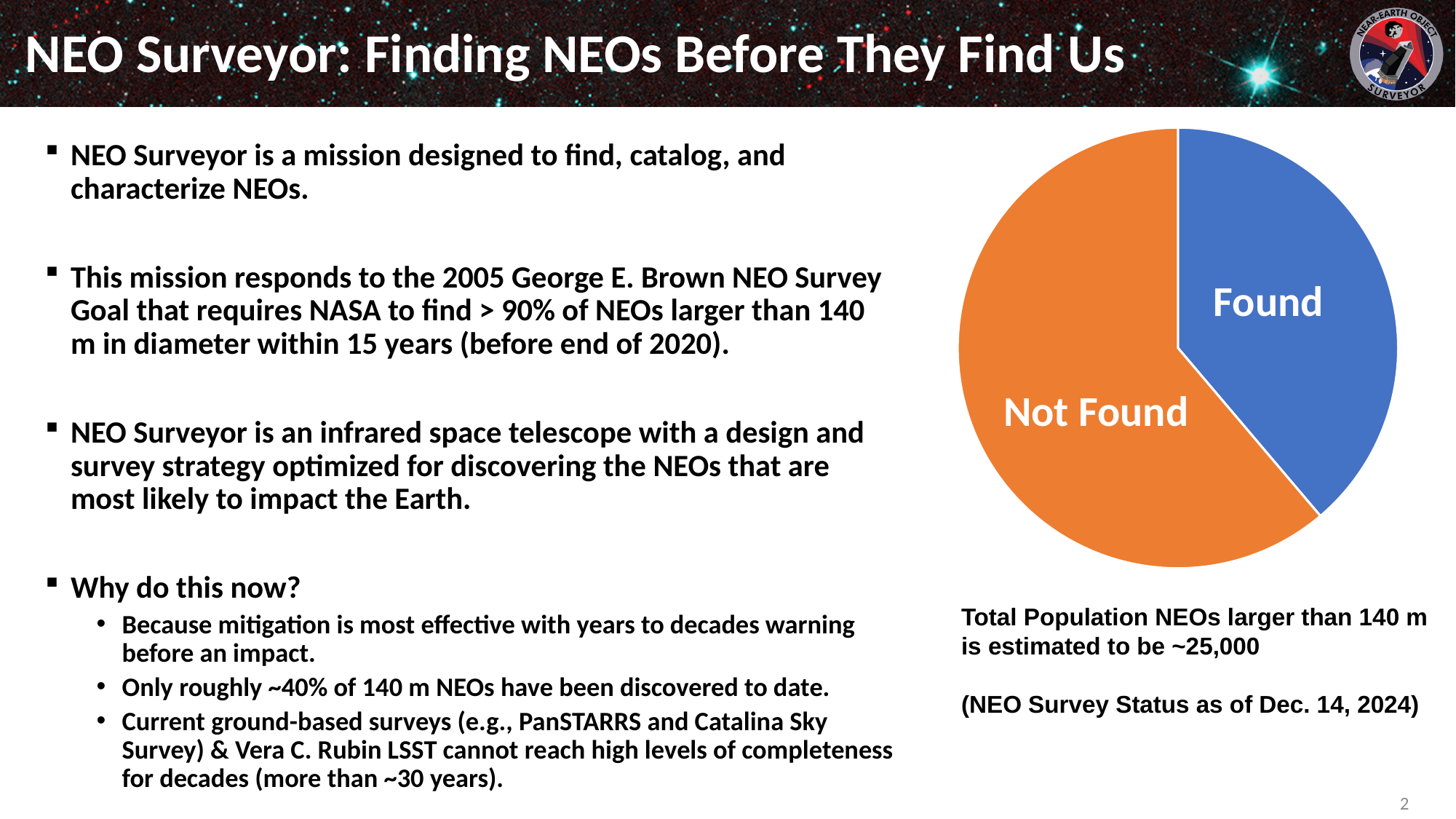
What kind of chart is shown on the slide? pie chart Which slice is larger in the pie chart, Found or Not Found? Not Found What are the labels of the two slices in the pie chart? Found and Not Found How many slices does the pie chart have? 2 What colour is the Found slice in the pie chart? blue Is the Found slice more or less than half of the pie chart? less What colour is the Not Found slice in the pie chart? orange Which slice of the pie chart is the smallest? Found Which slice of the pie chart is the largest? Not Found Is the Not Found slice more or less than half of the pie chart? more